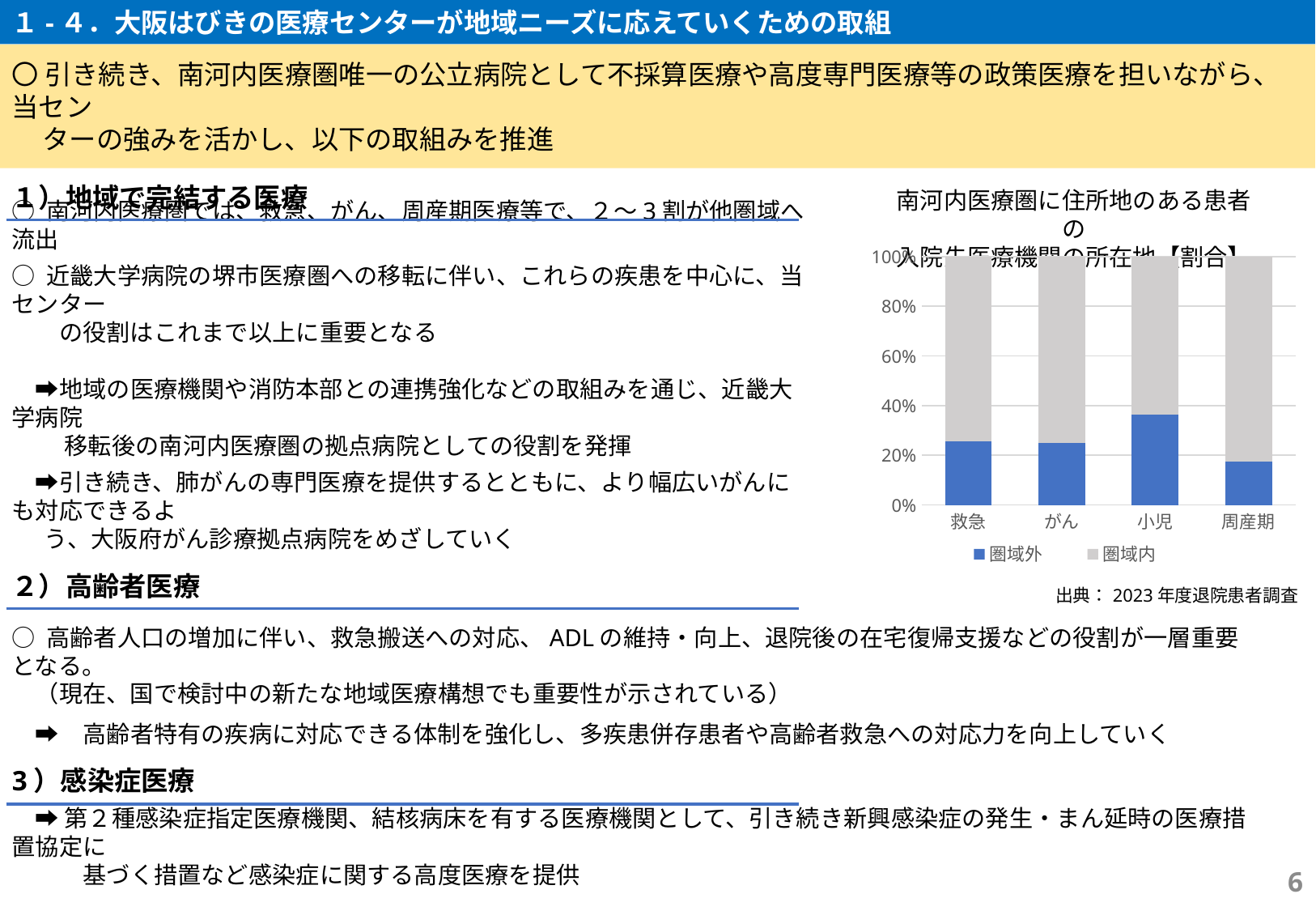
Which category has the lowest 圏域外 share in the chart? 周産期 How many categories are shown on the x axis of the chart? 4 Is the 圏域外 value for 周産期 greater or less than 20%? less How many series does the chart's legend list? 2 Is the 圏域外 value for 小児 greater or less than 20%? greater Is the 圏域外 value for 小児 greater or less than 40%? less Which colour represents 圏域内 in the chart? Gray What source is cited below the chart? 2023年度退院患者調査 Which category has the highest 圏域外 share in the chart? 小児 Which has the larger 圏域外 share, 小児 or 周産期? 小児 What kind of chart is shown on the slide? Stacked bar chart